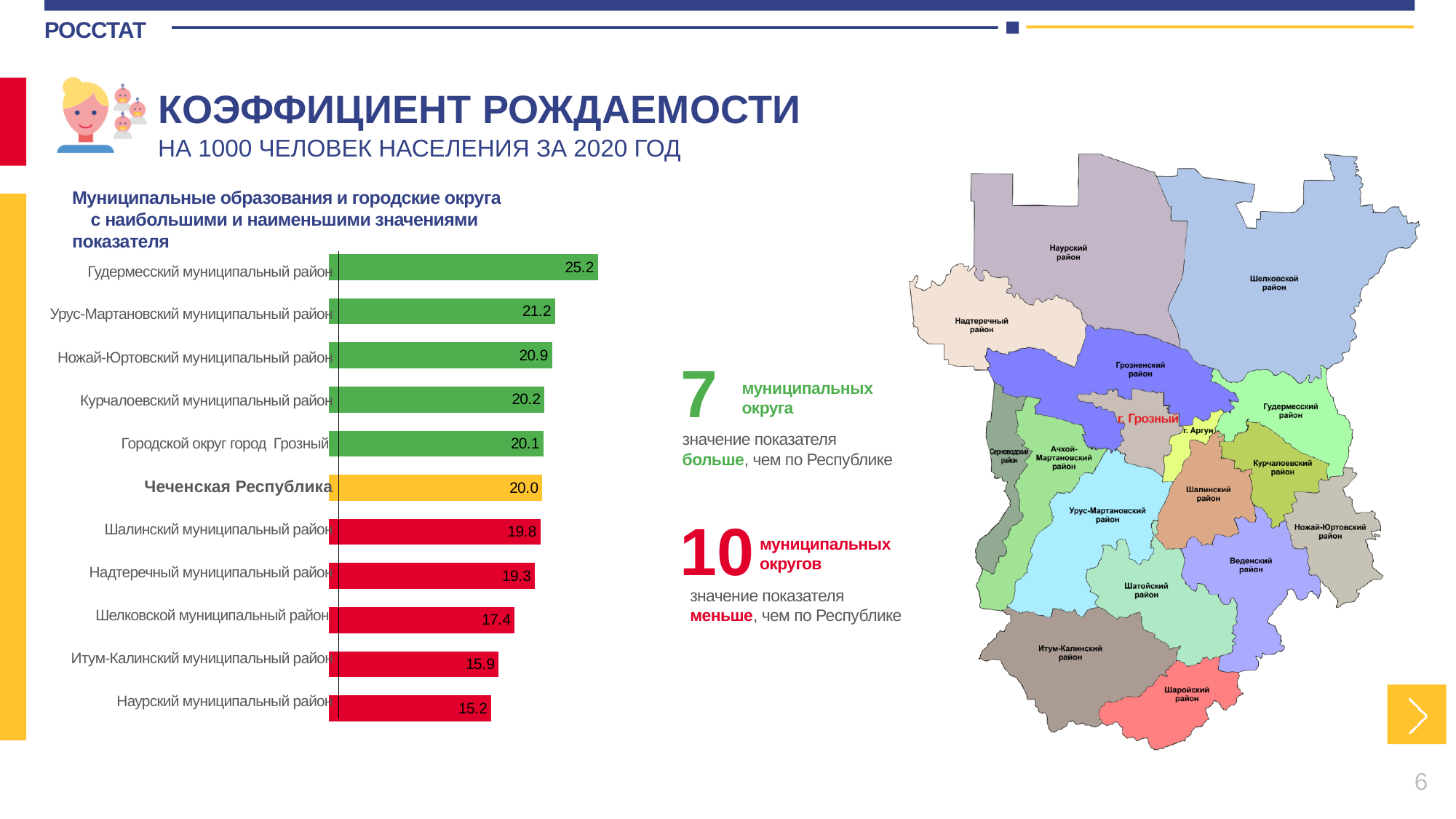
Do the values rise or fall going from the top bar to the bottom bar? Fall What value is shown for Чеченская Республика? 20.0 Which is larger: the value for Шалинский муниципальный район or Надтеречный муниципальный район? Шалинский муниципальный район Which category has the highest value in the chart? Гудермесский муниципальный район What is the difference between the values for Гудермесский муниципальный район and Наурский муниципальный район? 10.0 Which category has the lowest value in the chart? Наурский муниципальный район What is the birth rate value for Гудермесский муниципальный район? 25.2 How many categories (bars) are shown in the chart? 11 What is the value for Наурский муниципальный район? 15.2 What is the value for Городской округ город Грозный? 20.1 What kind of chart is shown on the slide? Bar chart What colour is the bar for Чеченская Республика? Yellow